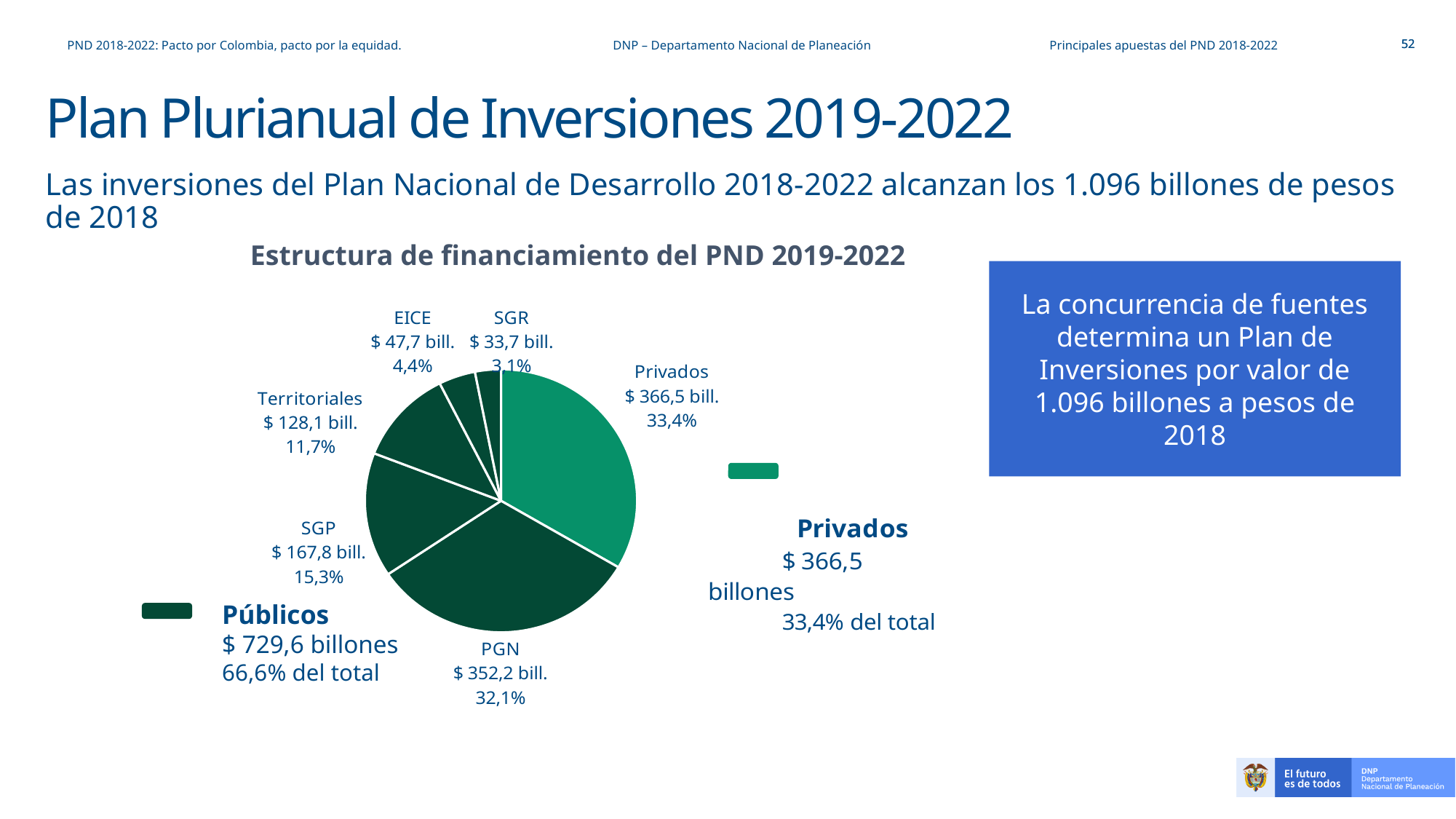
What percentage of the pie does the PGN slice represent? 32,1% Which slice of the pie chart is the smallest? SGR What kind of chart is shown under the title "Estructura de financiamiento del PND 2019-2022"? Pie chart What percentage share is shown for Territoriales? 11,7% What is the value shown for the SGP slice? $ 167,8 bill. What is the value shown for the Privados slice of the pie chart? $ 366,5 bill. What is the difference in billions between the Privados slice ($ 366,5 bill.) and the PGN slice ($ 352,2 bill.)? $ 14,3 bill. Which is larger, the EICE slice or the SGR slice? EICE What is the title of the pie chart? Estructura de financiamiento del PND 2019-2022 Which slice of the pie chart is the largest? Privados How many slices does the pie chart have? 6 What is the value shown for the EICE slice? $ 47,7 bill.